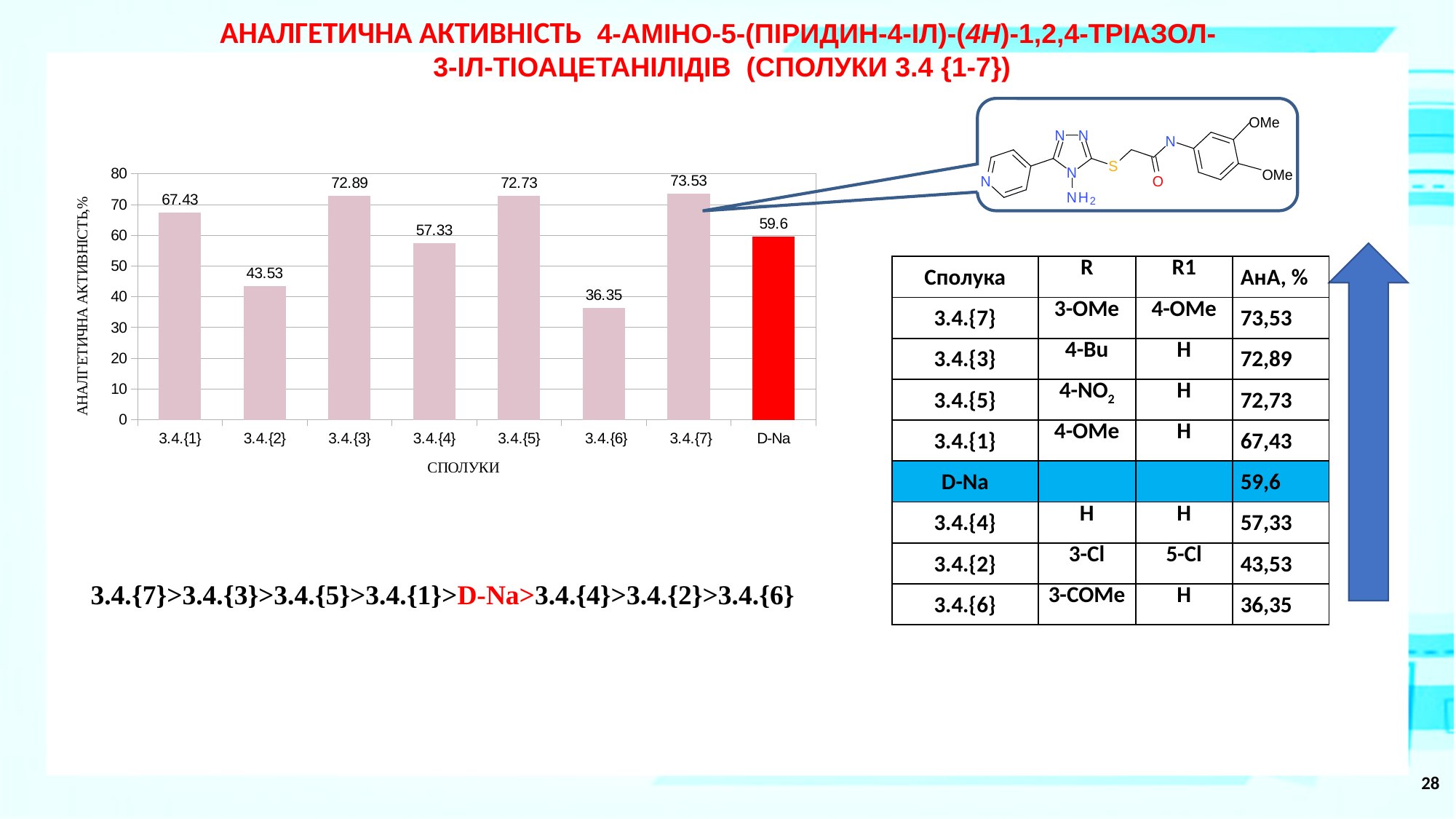
Which is larger, the value for 3.4.{4} or the value for D-Na? D-Na Which category has the highest bar in the chart? 3.4.{7} Which category has the lowest bar in the chart? 3.4.{6} Is the value for 3.4.{6} greater or less than 40? less Which bar in the chart is coloured red? D-Na What is the difference between the values for 3.4.{1} and 3.4.{4}? 10.1 What is the difference between the values for 3.4.{7} and D-Na? 13.93 How many categories are shown on the x axis of the chart? 8 What value is labelled on the bar for 3.4.{2}? 43.53 What is the value shown for D-Na? 59.6 What is the analgesic activity value shown for compound 3.4.{7}? 73.53 What type of chart is shown on the slide? bar chart